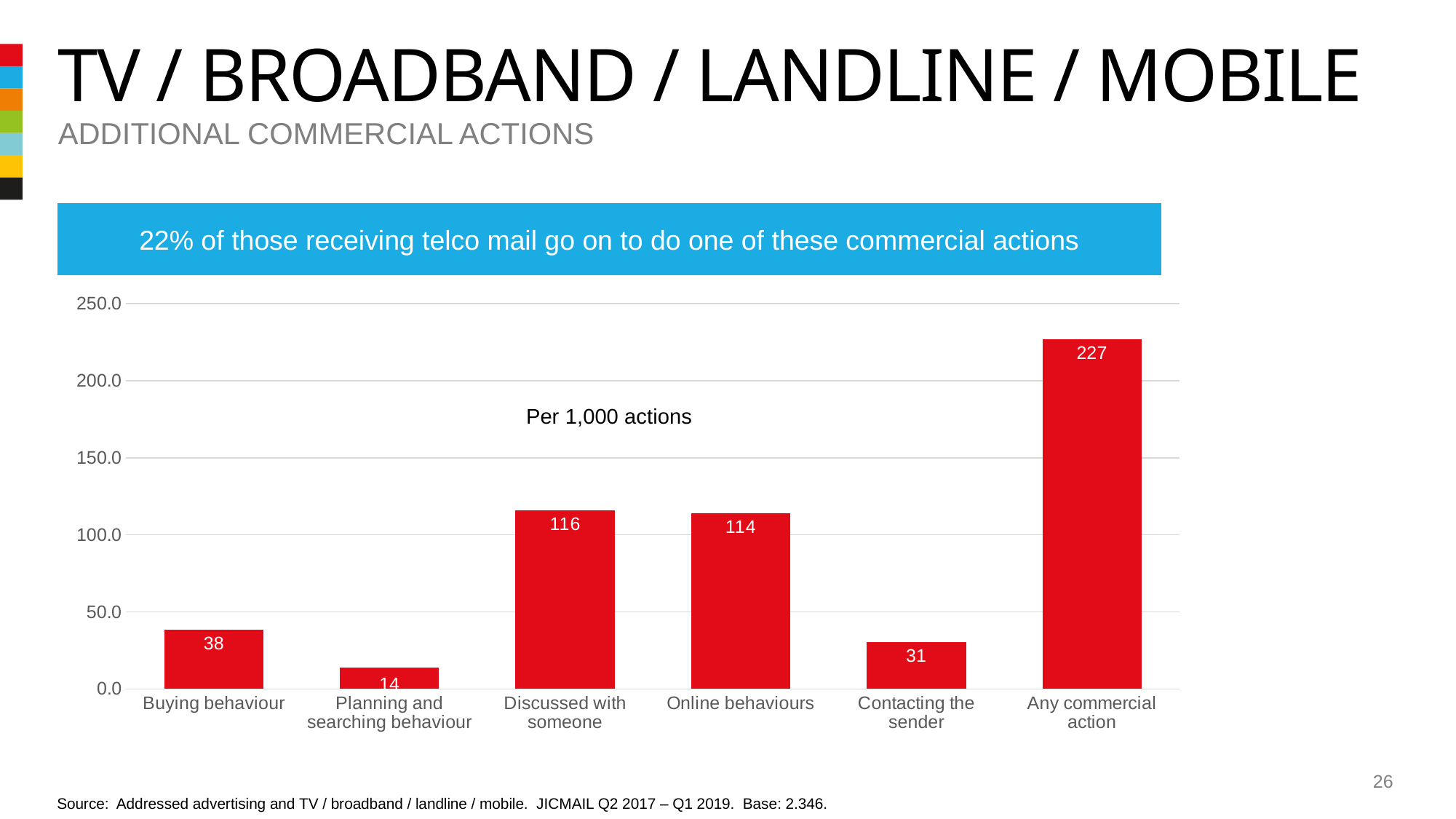
What is the value for Buying behaviour? 38 How many categories are shown on the x axis? 6 Which is larger, Buying behaviour or Contacting the sender? Buying behaviour What unit label is printed inside the chart area? Per 1,000 actions What is the difference between Any commercial action and Discussed with someone? 111 What is the value for Any commercial action? 227 Is the value for Online behaviours greater or less than 100.0? greater What kind of chart is shown on the slide? bar chart What is the value for Contacting the sender? 31 Which category has the lowest value? Planning and searching behaviour What is the value for Discussed with someone? 116 Which category has the highest value? Any commercial action